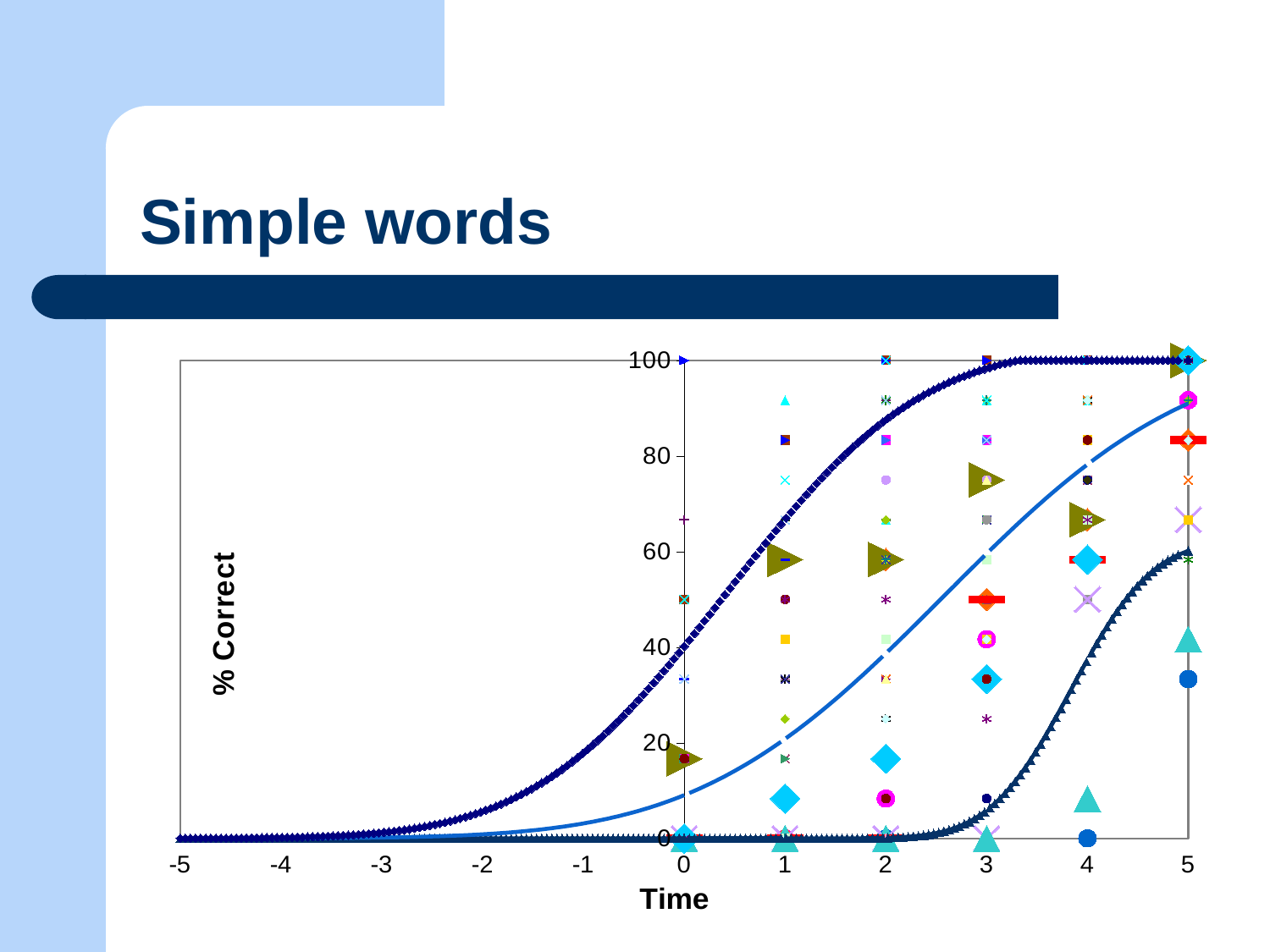
What is the highest value shown on the y axis of the chart? 100 What is the lowest value shown on the x axis of the chart? -5 How many tick labels are shown on the x axis of the chart? 11 What kind of chart is shown on the slide? scatter chart Is the value of the uppermost fitted curve at Time 1 greater or less than 60? greater Is the value of the lowest fitted curve at Time 3 greater or less than 20? less Is the value of the middle fitted curve at Time 5 greater or less than 80? greater Do the fitted curves in the chart rise or fall as Time increases? rise What is the title of the x axis of the chart? Time How many tick labels are shown on the y axis of the chart? 6 What is the title of the y axis of the chart? % Correct What is the highest value shown on the x axis of the chart? 5